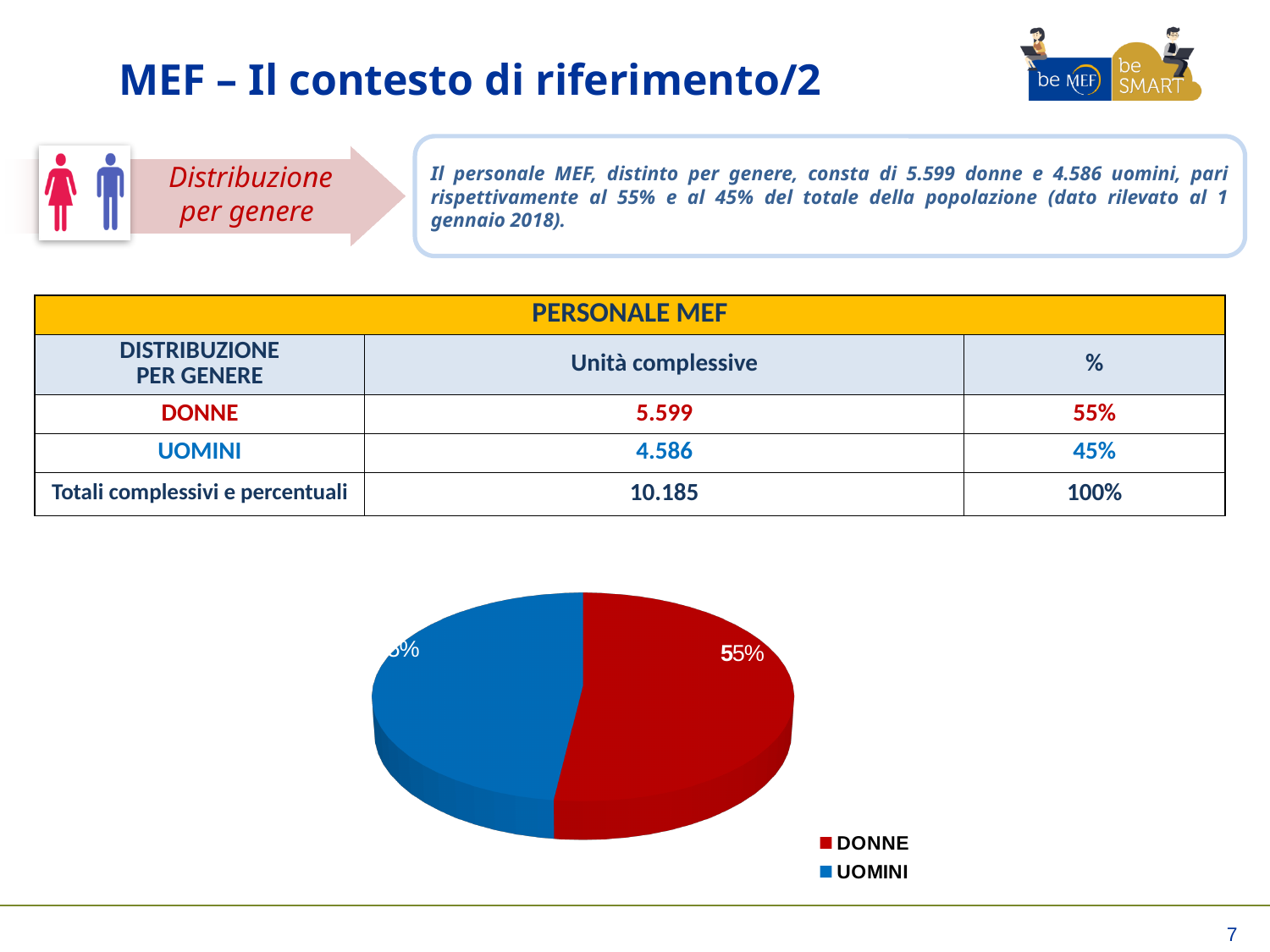
What is the difference in percentage points between the DONNE and UOMINI slices? 10% What share of the pie chart does DONNE represent? 55% How many entries does the pie chart legend list? 2 Which is larger in the pie chart, DONNE or UOMINI? DONNE What colour is the DONNE slice in the pie chart? red Which slice of the pie chart is the smallest? UOMINI What share of the pie chart does UOMINI represent? 45% What kind of chart is shown on the slide? pie chart Which slice of the pie chart is the largest? DONNE How many slices does the pie chart have? 2 Is the share for DONNE in the pie chart greater or less than 50%? greater What colour is the UOMINI slice in the pie chart? blue